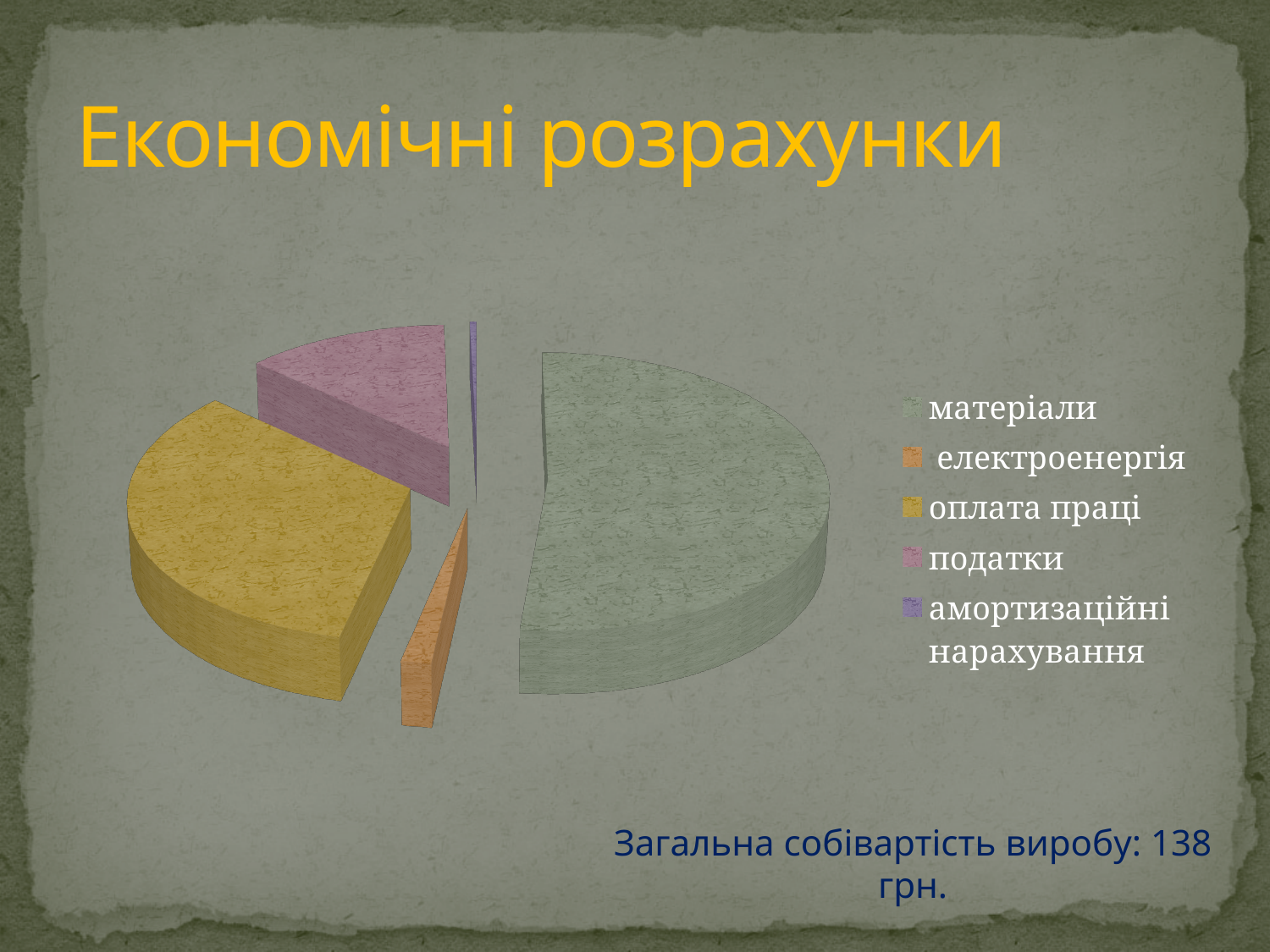
How many entries does the legend of the pie chart list? 5 Which slice is larger, податки or амортизаційні нарахування? податки Which slice is larger, оплата праці or податки? оплата праці How many slices does the pie chart have? 5 Which slice is larger, оплата праці or електроенергія? оплата праці What is the title of the slide containing the pie chart? Економічні розрахунки Which category is shown in yellow in the pie chart? оплата праці What kind of chart is shown on the slide? pie chart Which category has the largest slice of the pie chart? матеріали Which category has the smallest slice of the pie chart? амортизаційні нарахування